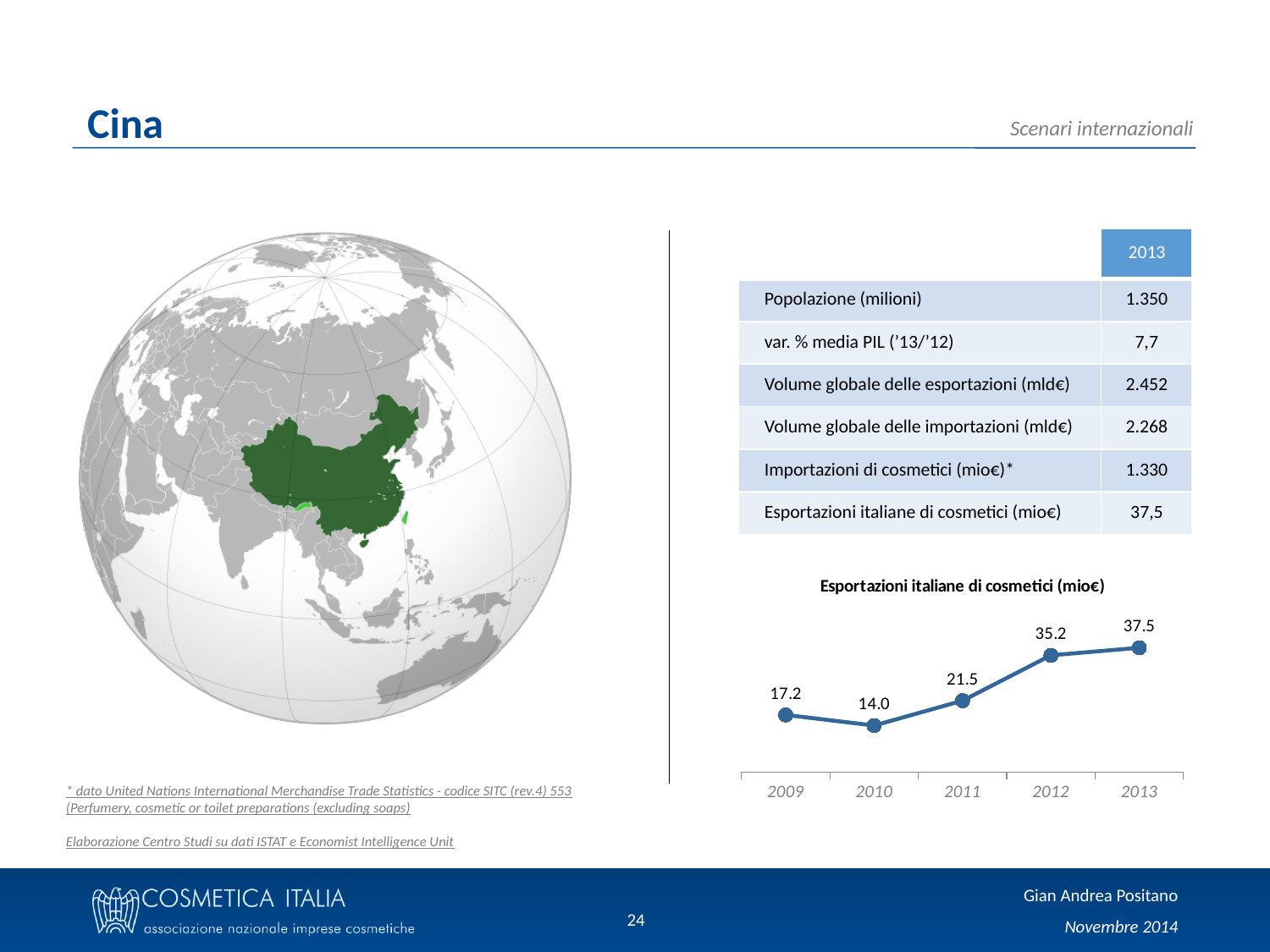
How many years are plotted in the chart? 5 Which year has the lowest value in the chart? 2010 What is the value for 2011 in the chart? 21.5 What is the difference between the values for 2013 and 2012 in the chart? 2.3 What is the value for 2013 in the chart? 37.5 Which year has the highest value in the chart? 2013 What is the value for 2012 in the chart? 35.2 Which is larger in the chart, the value for 2009 or the value for 2010? 2009 What is the title of the chart on the slide? Esportazioni italiane di cosmetici (mio€) What kind of chart is shown on the slide? line chart What is the value for 2009 in the chart 'Esportazioni italiane di cosmetici (mio€)'? 17.2 What is the value for 2010 in the chart? 14.0